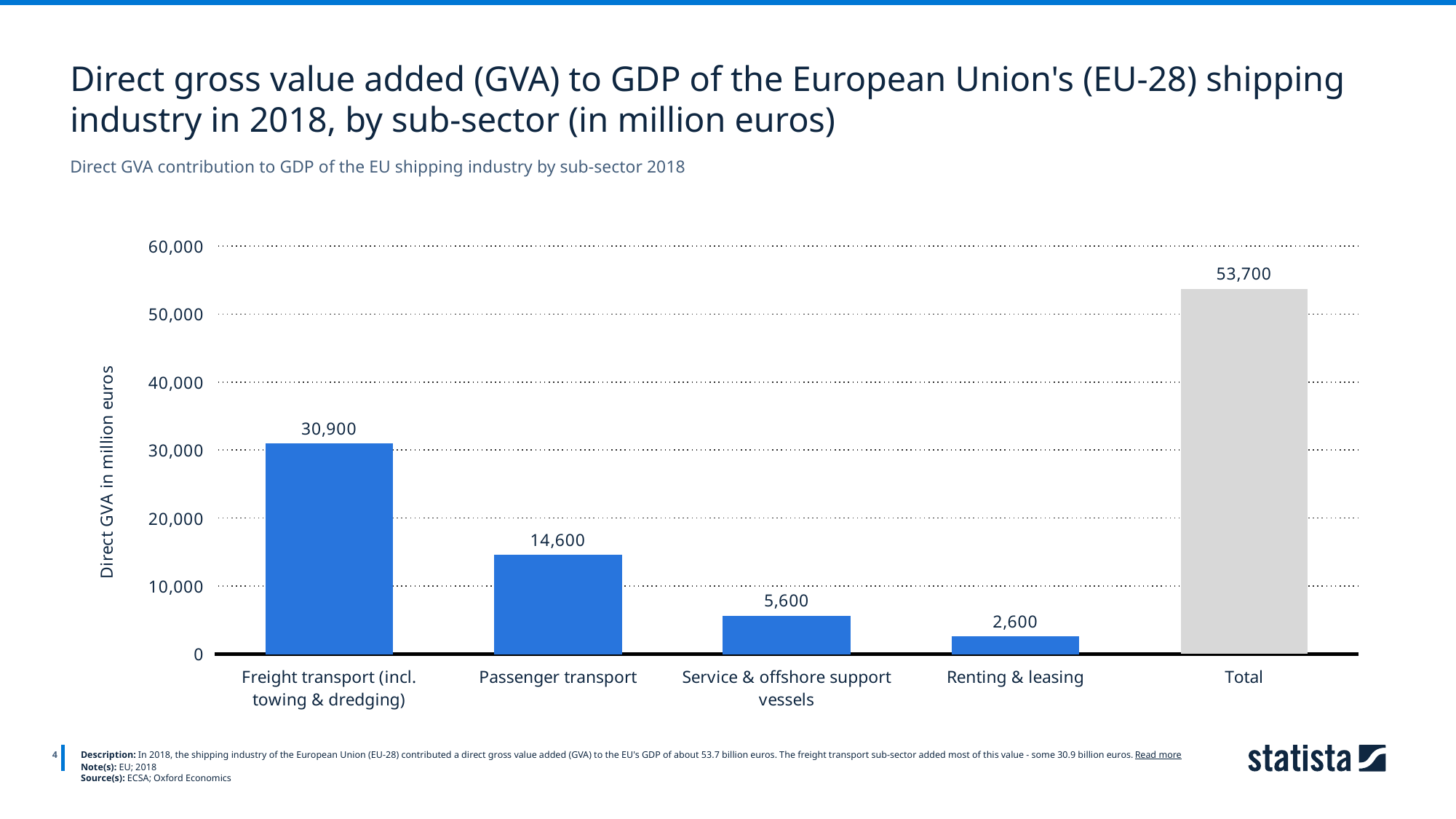
Which sub-sector (excluding Total) has the highest direct GVA? Freight transport (incl. towing & dredging) What is the difference between the direct GVA of Freight transport (incl. towing & dredging) and Passenger transport? 16,300 Is the value for Freight transport (incl. towing & dredging) greater or less than 30,000? greater What is the direct GVA value for Renting & leasing? 2,600 What is the value shown for the Total bar? 53,700 Which is larger, the direct GVA for Service & offshore support vessels or for Renting & leasing? Service & offshore support vessels Which category has the lowest direct GVA? Renting & leasing What is the direct GVA value for Passenger transport? 14,600 What is the direct GVA value for Service & offshore support vessels? 5,600 What type of chart is shown on the slide? Bar chart How many bars are shown in the chart? 5 What is the label of the vertical axis? Direct GVA in million euros